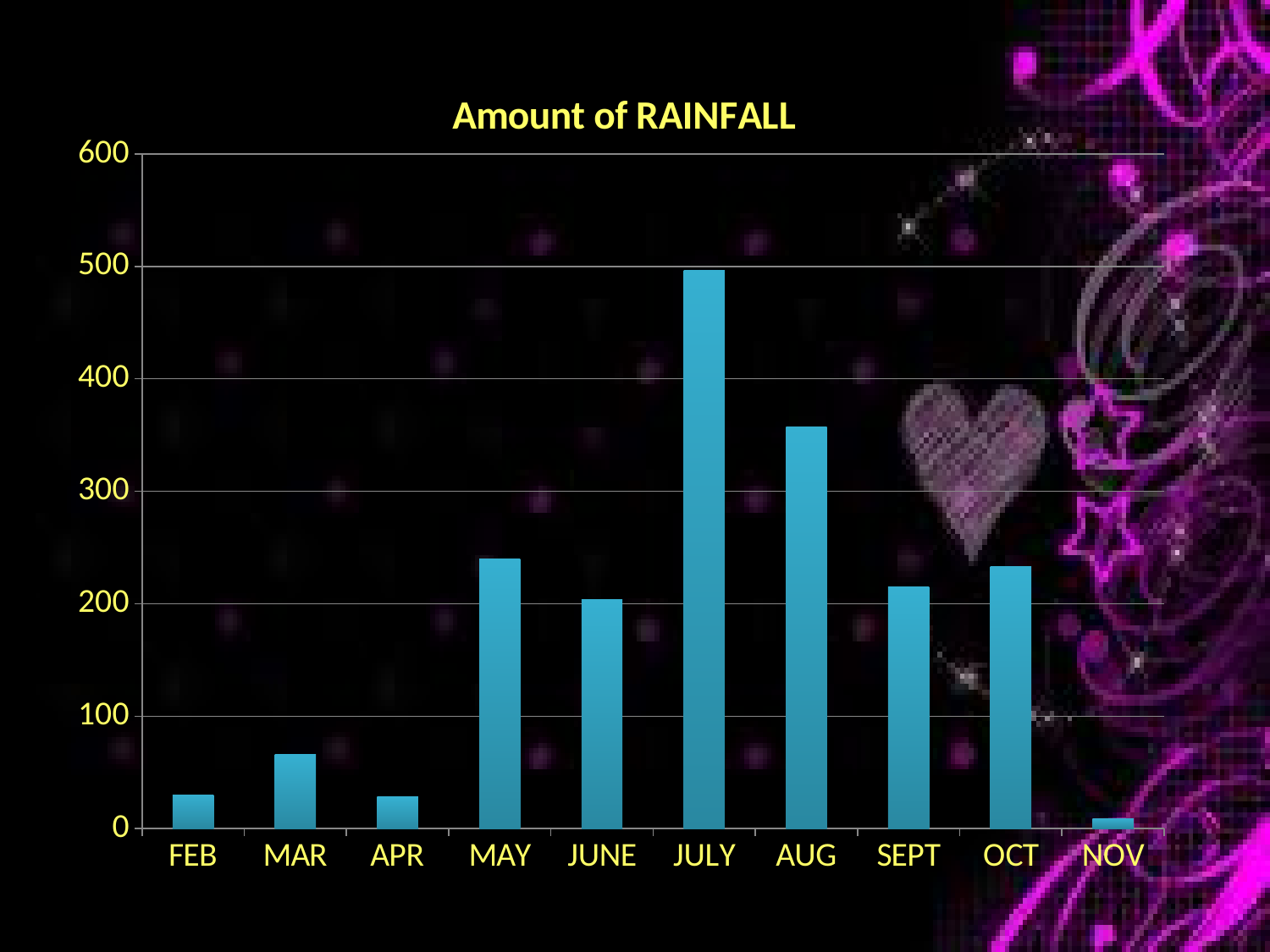
Is the value for AUG greater or less than 300? greater Do the rainfall values rise or fall from APR to JULY? rise Which month has more rainfall, AUG or MAY? AUG What is the title of the chart? Amount of RAINFALL Is the value for MAY greater or less than 200? greater Which month has the lowest amount of rainfall? NOV Is the value for JULY greater or less than 400? greater Which month has the highest amount of rainfall? JULY Which month has more rainfall, MAY or JUNE? MAY How many months are shown on the x axis of the chart? 10 What kind of chart is shown on the slide? bar chart